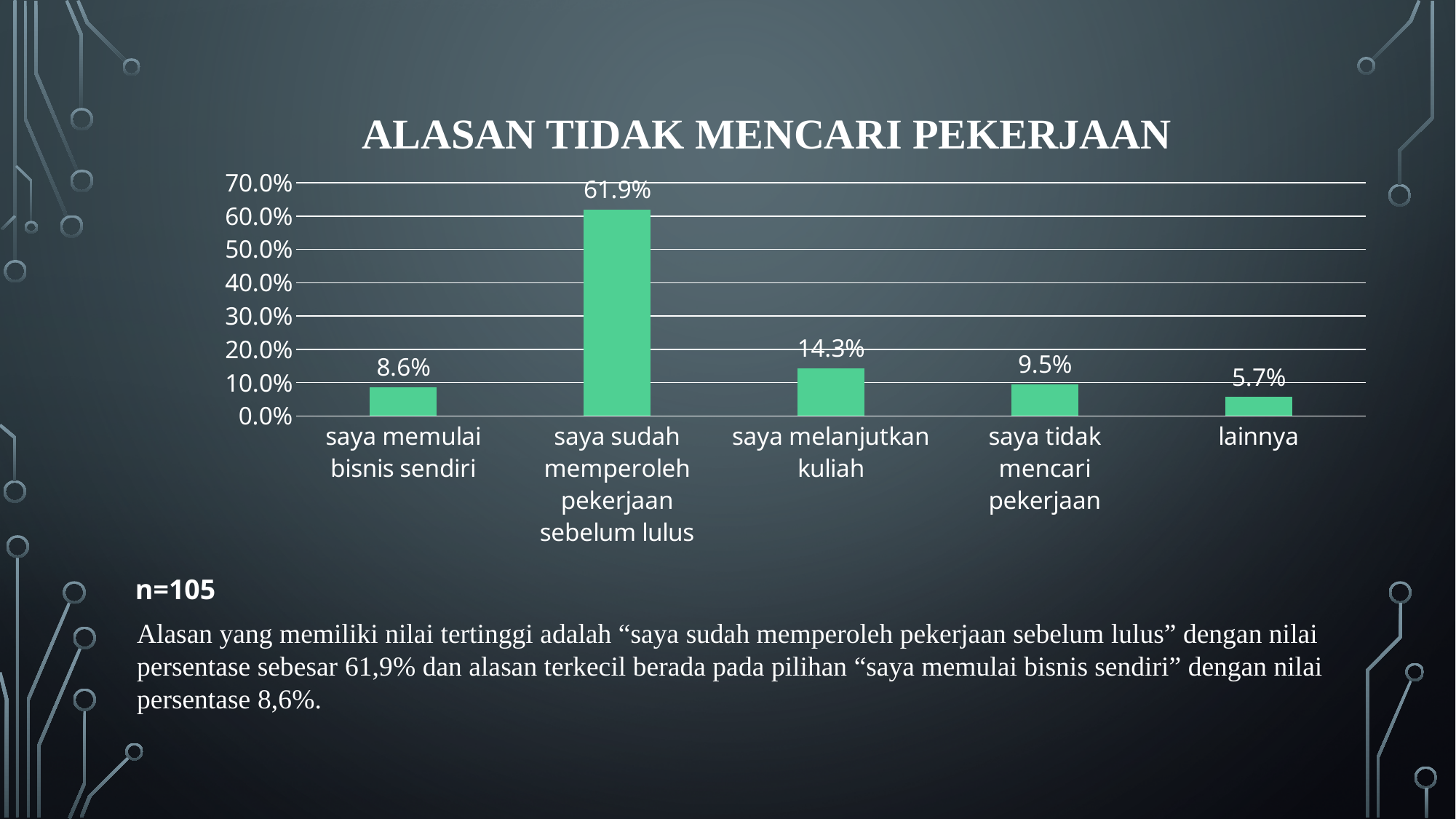
What is the value for "saya melanjutkan kuliah"? 14.3% What is the difference between the values for "saya sudah memperoleh pekerjaan sebelum lulus" and "saya melanjutkan kuliah"? 47.6% What is the value for "saya tidak mencari pekerjaan"? 9.5% How many categories are shown on the x axis? 5 What is the value for "saya sudah memperoleh pekerjaan sebelum lulus"? 61.9% What is the value for "lainnya"? 5.7% Which category has the lowest value? lainnya Which is larger, the value for "saya memulai bisnis sendiri" or the value for "saya tidak mencari pekerjaan"? saya tidak mencari pekerjaan Which category has the highest value? saya sudah memperoleh pekerjaan sebelum lulus Is the value for "saya sudah memperoleh pekerjaan sebelum lulus" greater or less than 50.0%? greater What is the title of the chart? ALASAN TIDAK MENCARI PEKERJAAN What kind of chart is shown on the slide? bar chart